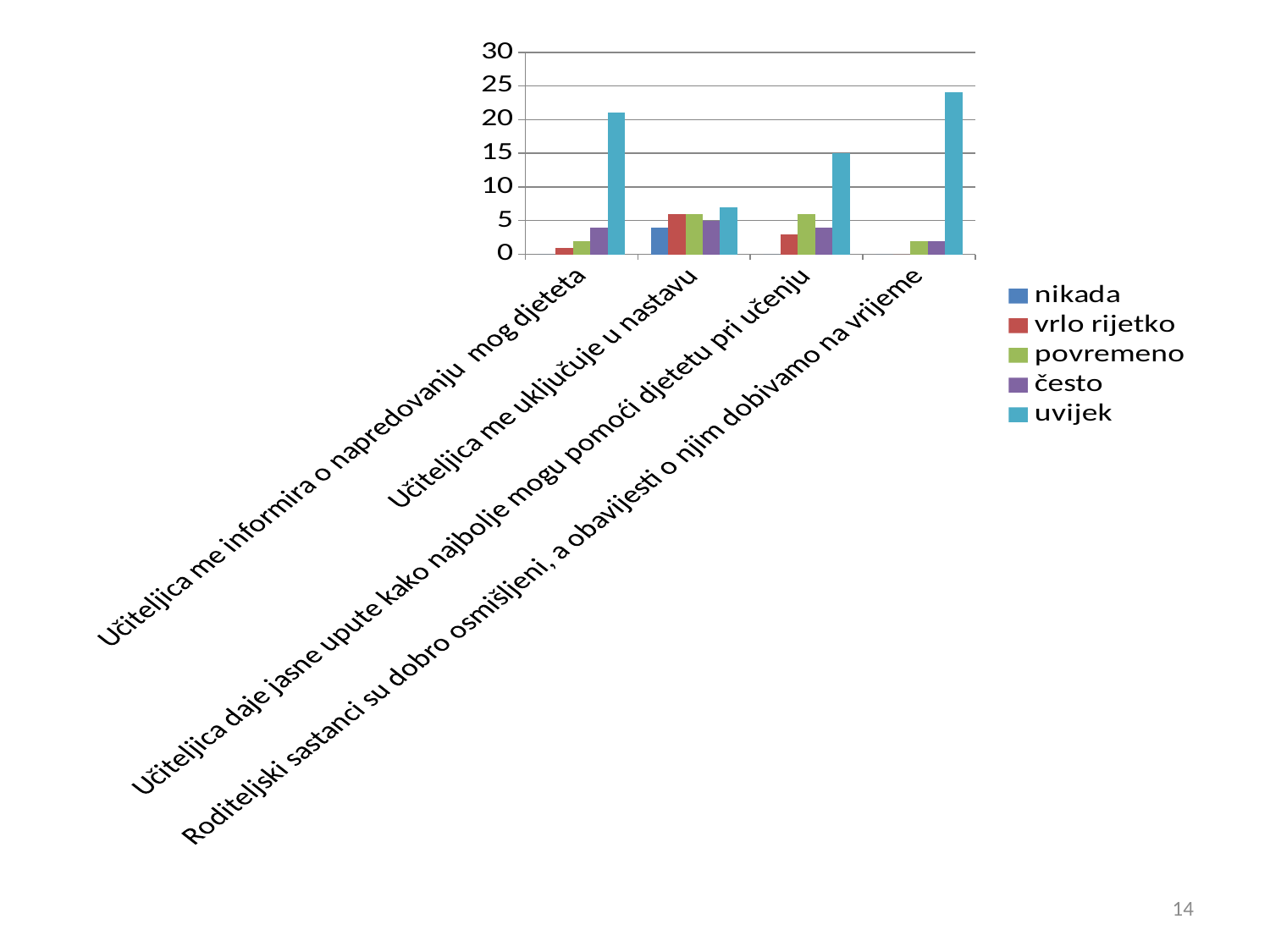
Which category has the highest value for the series "uvijek"? Roditeljski sastanci su dobro osmišljeni, a obavijesti o njim dobivamo na vrijeme What kind of chart is shown on the slide? bar chart Which series has the highest value for "Učiteljica daje jasne upute kako najbolje mogu pomoći djetetu pri učenju"? uvijek Which series is listed first in the legend? nikada Is the value of "uvijek" for "Učiteljica me informira o napredovanju mog djeteta" greater or less than 20? greater How many series does the legend list? 5 Is the value of "uvijek" for "Roditeljski sastanci su dobro osmišljeni, a obavijesti o njim dobivamo na vrijeme" greater or less than 20? greater How many categories are shown on the x axis of the chart? 4 Which series is listed last in the legend? uvijek Is the value of "uvijek" for "Učiteljica me uključuje u nastavu" greater or less than 10? less Which category has the lowest value for the series "uvijek"? Učiteljica me uključuje u nastavu Which is larger: the "uvijek" value for "Učiteljica me informira o napredovanju mog djeteta" or for "Učiteljica daje jasne upute kako najbolje mogu pomoći djetetu pri učenju"? Učiteljica me informira o napredovanju mog djeteta